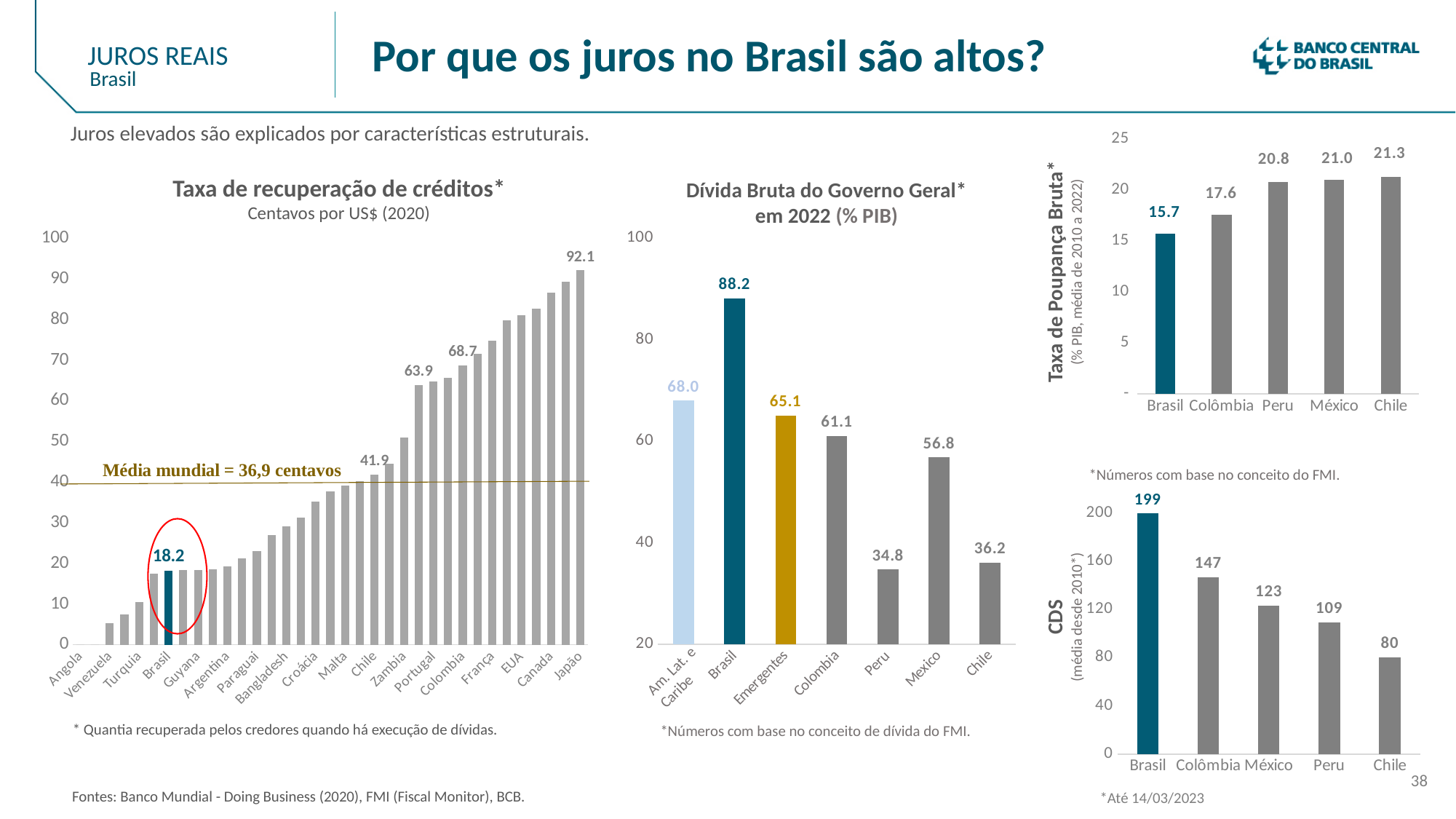
How many categories are shown in the 'Dívida Bruta do Governo Geral em 2022 (% PIB)' chart? 7 In the 'Dívida Bruta do Governo Geral em 2022 (% PIB)' chart, what is the difference between Brasil and Colombia? 27.1 What type of chart is the 'CDS' chart? bar chart In the 'Taxa de recuperação de créditos' chart, is the value for Angola greater or less than 10? less In the 'Taxa de Poupança Bruta' chart, which country has the lowest value? Brasil In the 'Taxa de Poupança Bruta' chart, what is the value for Colômbia? 17.6 In the 'Dívida Bruta do Governo Geral em 2022 (% PIB)' chart, what is the value for Brasil? 88.2 In the 'CDS' chart, what is the value for Chile? 80 In the 'Dívida Bruta do Governo Geral em 2022 (% PIB)' chart, which category has the lowest value? Peru In the 'CDS' chart, what is the difference between Brasil and Colômbia? 52 In the 'CDS' chart, which country has the highest value? Brasil In the 'Taxa de recuperação de créditos' chart, what is the value for Brasil? 18.2